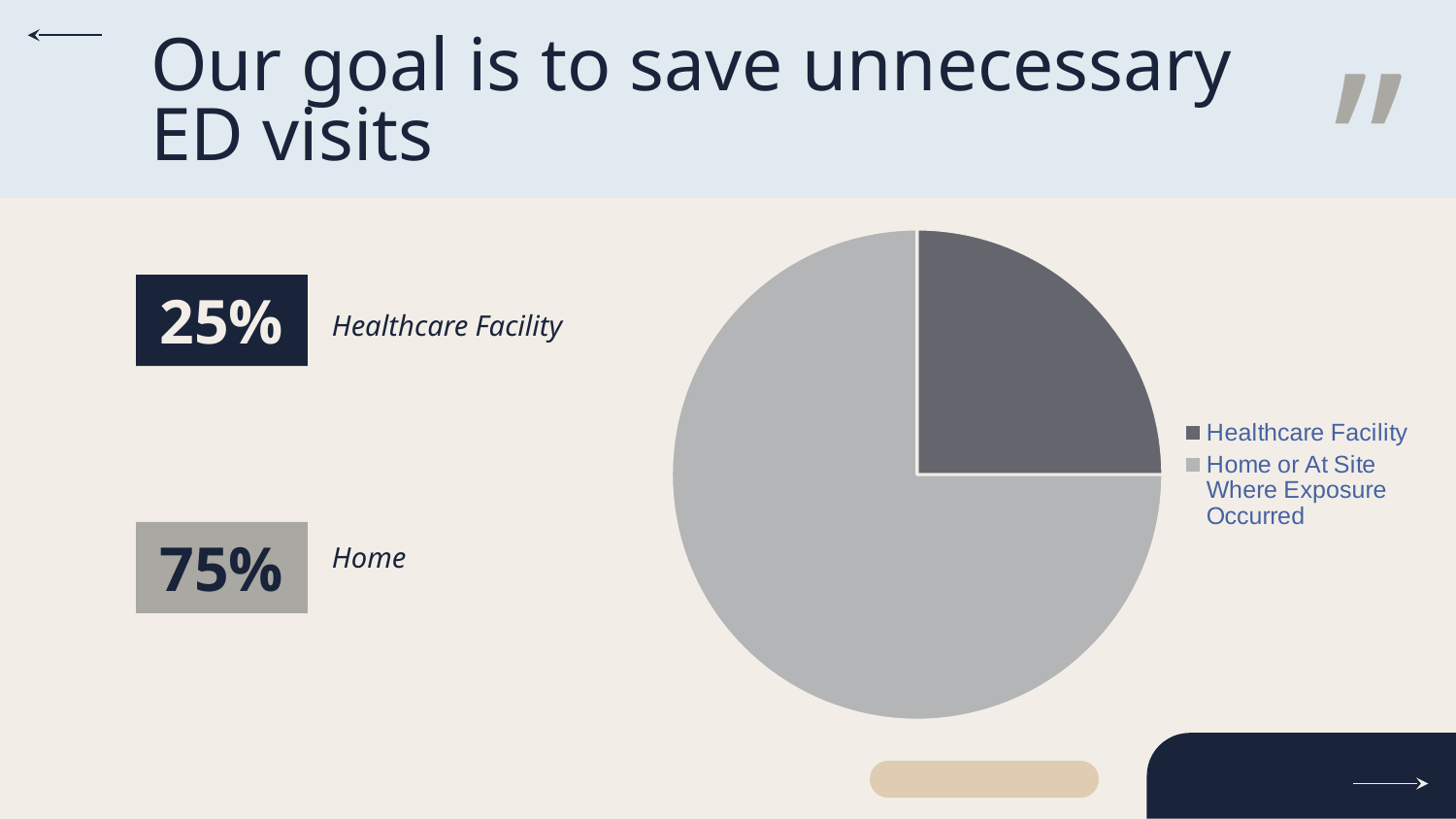
What share of the pie does the Healthcare Facility slice represent? 25% Is the Healthcare Facility share of the pie greater or less than 50%? less Which legend entry is shown in the darker grey colour? Healthcare Facility Which slice of the pie chart is the smallest? Healthcare Facility What is the difference in percentage points between the Home share and the Healthcare Facility share? 50% Which is larger in the pie chart: the Healthcare Facility slice or the Home or At Site Where Exposure Occurred slice? Home or At Site Where Exposure Occurred How many entries does the pie chart's legend list? 2 What share of the pie does the Home or At Site Where Exposure Occurred slice represent? 75% What kind of chart is shown on the slide? pie chart What is the title text at the top of the slide? Our goal is to save unnecessary ED visits Which slice of the pie chart is the largest? Home or At Site Where Exposure Occurred How many slices does the pie chart have? 2